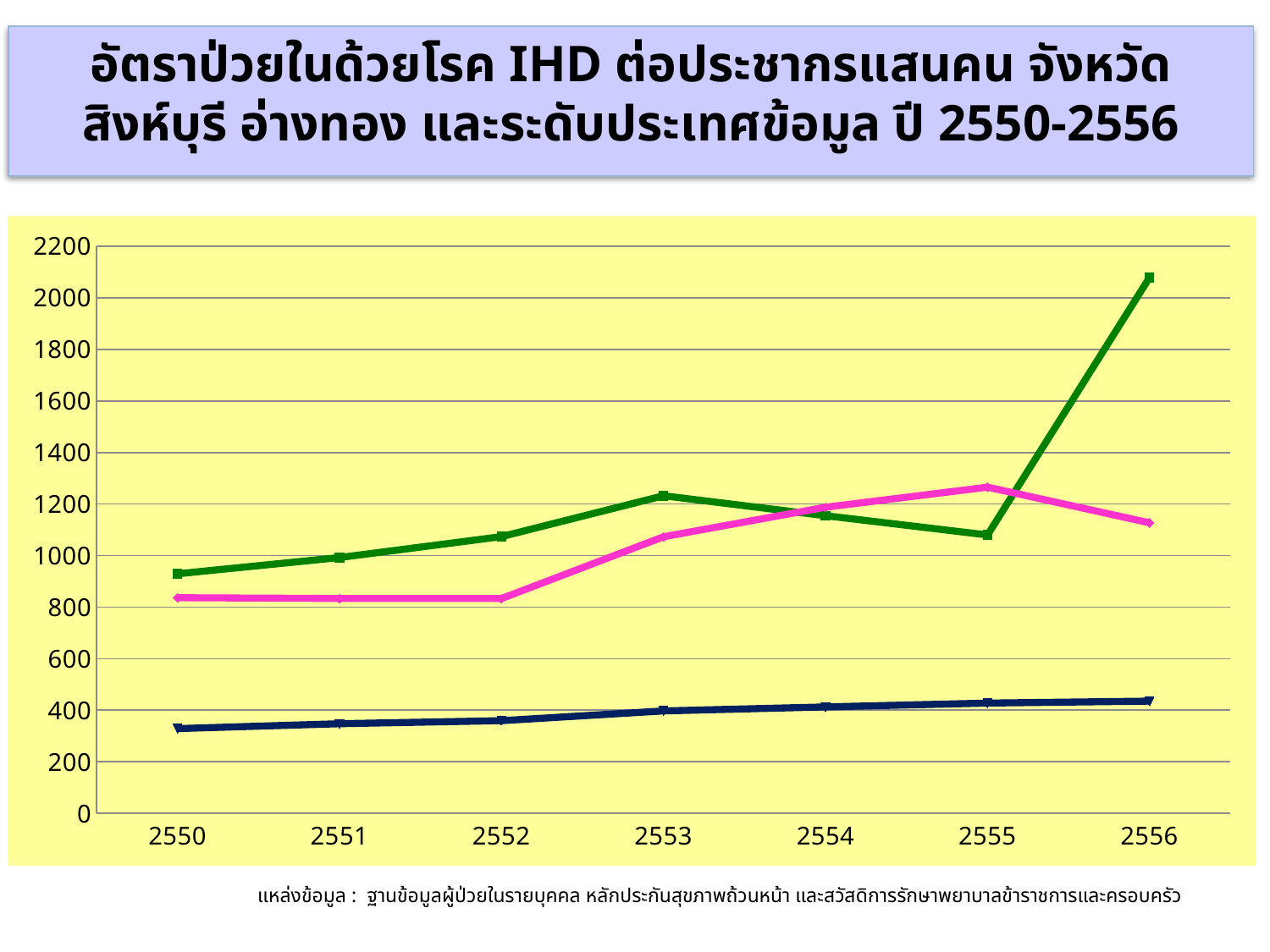
In which year does the dark blue line have its lowest value? 2550 Is the value of the green line in 2556 greater or less than 2000? greater What kind of chart is shown on the slide? line chart How many years are shown on the x axis of the chart? 7 Which range of years does the chart title say the data covers? 2550-2556 In which year does the pink line reach its highest value? 2555 In 2556, which line has the higher value, the green line or the pink line? green line Does the dark blue line rise or fall from 2550 to 2556? rise How many lines are plotted on the chart? 3 In which year does the green line reach its highest value? 2556 Is the value of the dark blue line in 2550 greater or less than 400? less Is the value of the pink line in 2552 greater or less than 1000? less